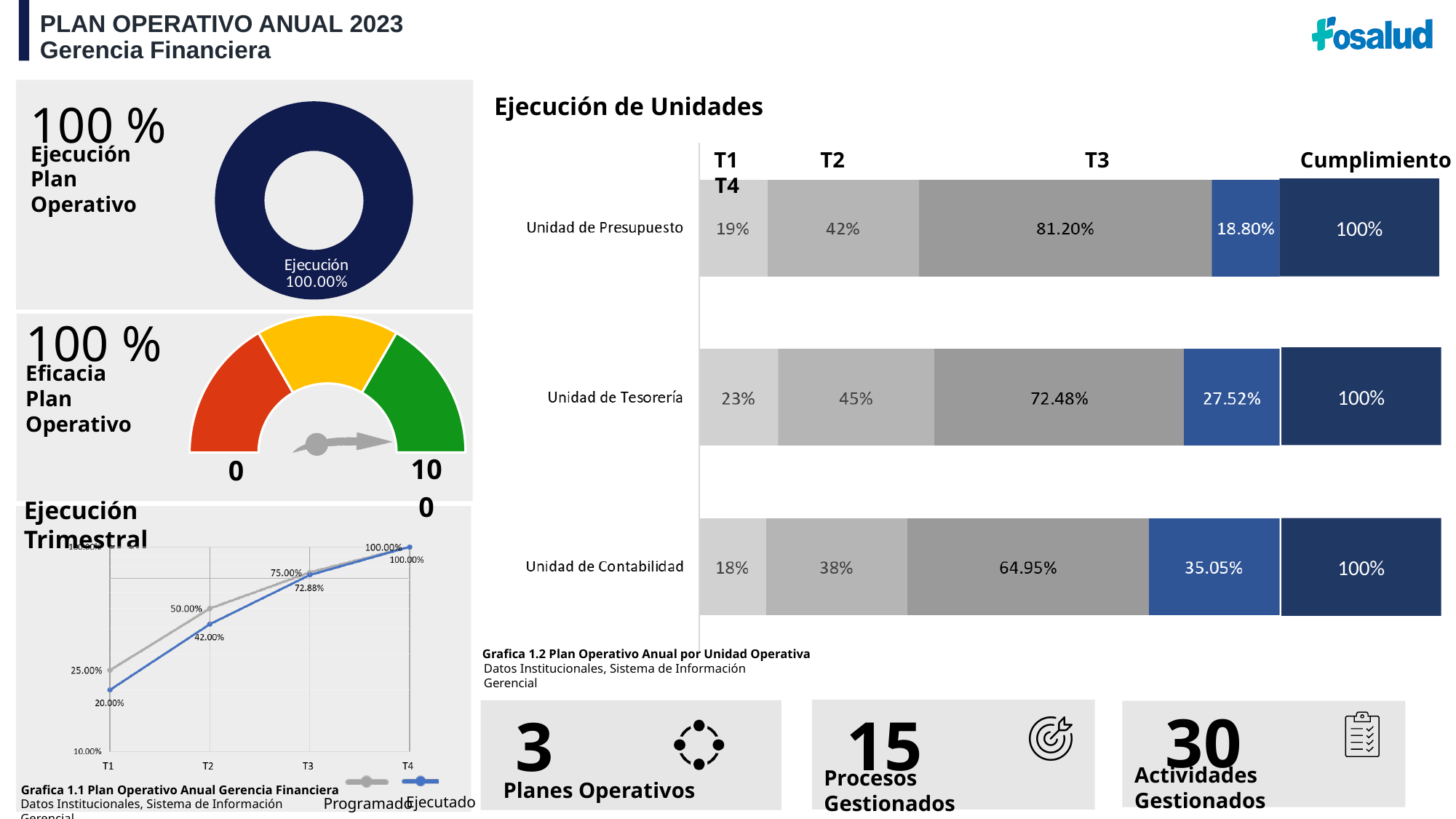
In the Ejecución de Unidades chart, which unit has the highest T1 value? Unidad de Tesorería How many series does the legend of the Ejecución Trimestral chart list? 2 In the Ejecución de Unidades chart, which has the larger T4 value, Unidad de Tesorería or Unidad de Presupuesto? Unidad de Tesorería In the Ejecución de Unidades chart, which unit has the lowest T2 value? Unidad de Contabilidad What kind of chart is the Ejecución de Unidades chart? Bar chart In the Ejecución de Unidades chart, what is the difference between the T3 values of Unidad de Presupuesto and Unidad de Contabilidad? 16.25 percentage points In the Ejecución Trimestral chart, what is the difference between Programado and Ejecutado at T2? 8.00 percentage points In the Ejecución Trimestral chart, does the Ejecutado line rise or fall from T1 to T4? Rises In the Ejecución de Unidades chart, what is the T4 value for Unidad de Contabilidad? 35.05% In the Ejecución Trimestral chart, what is the Ejecutado value at T3? 72.88% How many units are shown in the Ejecución de Unidades chart? 3 In the Ejecución de Unidades chart, what is the T3 value for Unidad de Tesorería? 72.48%